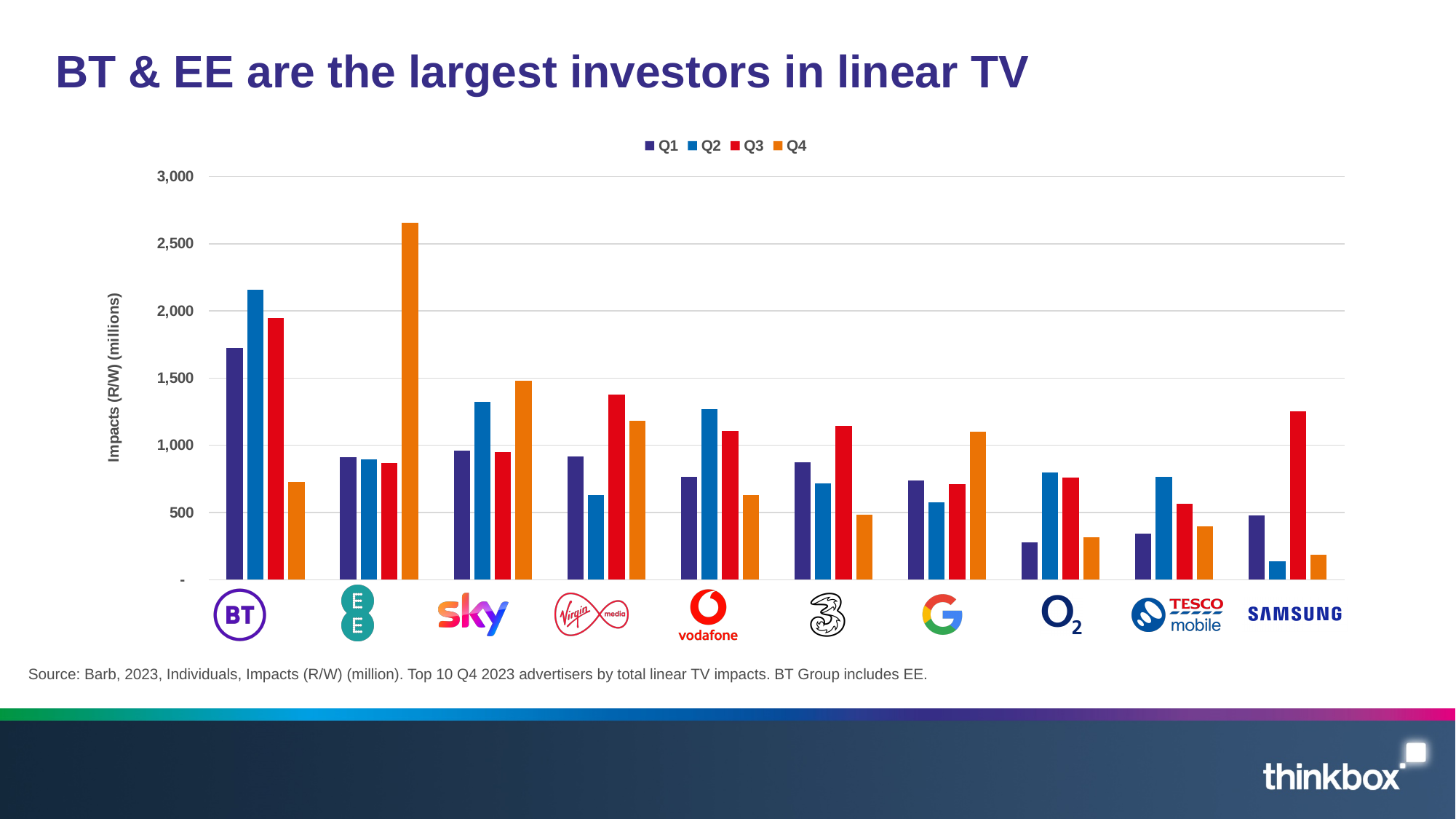
For Google, which is larger: the Q1 value or the Q4 value? Q4 How many series does the legend list? 4 What kind of chart is shown on the slide? bar chart What is the label on the y axis? Impacts (R/W) (millions) Is the Q2 value for BT greater or less than 2,000? greater Which advertiser has the lowest Q2 value? Samsung Which advertiser has the highest Q2 value? BT Which advertiser has the highest Q4 value? EE Is the Q4 value for EE greater or less than 2,500? greater How many advertisers are shown along the x axis? 10 Is the Q1 value for O2 greater or less than 500? less For Samsung, which is larger: the Q1 value or the Q3 value? Q3